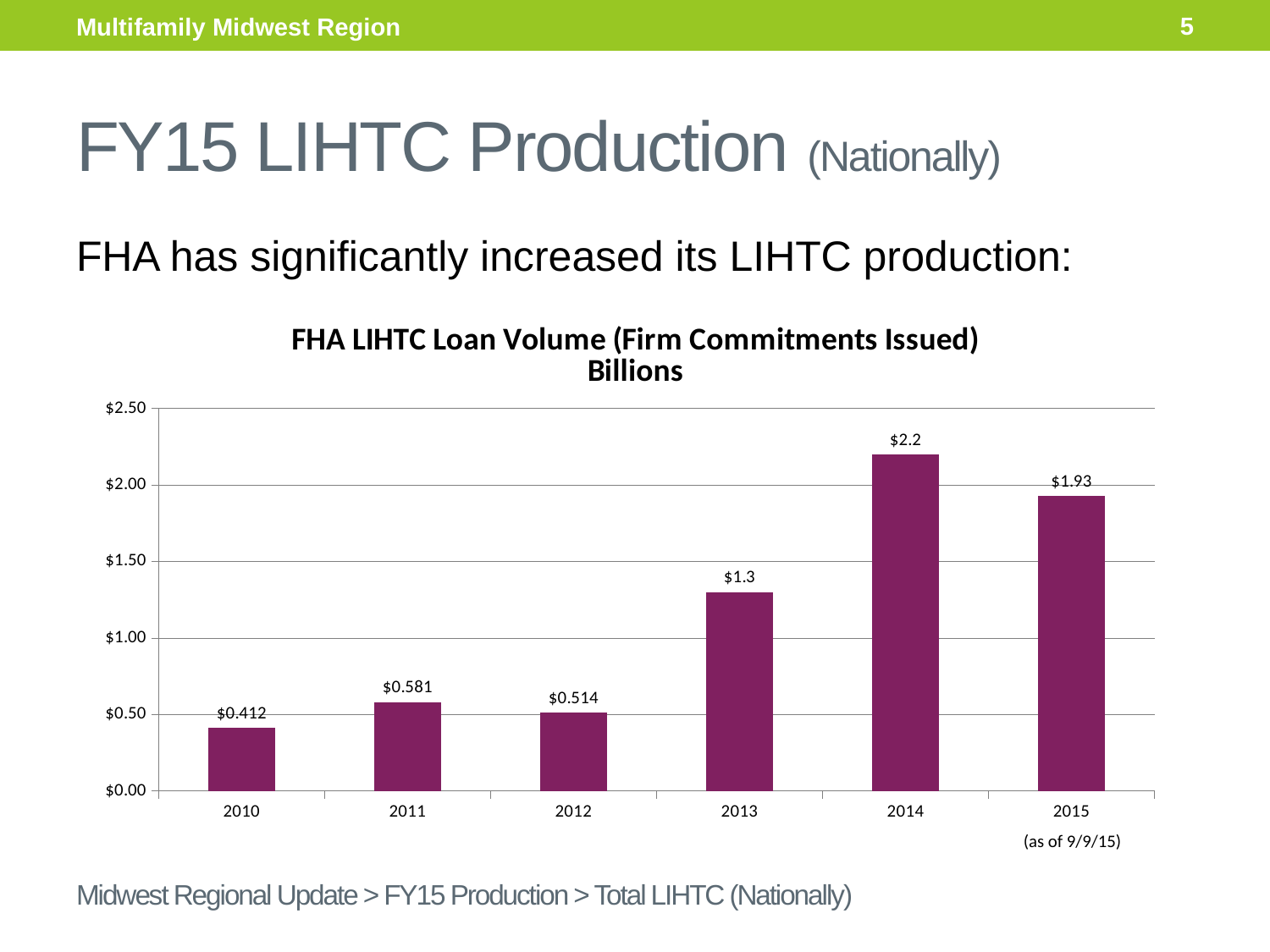
What is the difference between the 2014 and 2015 loan volumes? $0.27 What is the FHA LIHTC loan volume for 2010? $0.412 What is the FHA LIHTC loan volume for 2015? $1.93 Do the loan volumes rise or fall from 2012 to 2014? Rise What is the title of the chart? FHA LIHTC Loan Volume (Firm Commitments Issued) Billions What is the FHA LIHTC loan volume for 2013? $1.3 Which year has the highest FHA LIHTC loan volume? 2014 What kind of chart is shown on the slide? Bar chart How many years are shown on the chart? 6 Which year has the lowest FHA LIHTC loan volume? 2010 Is the value for 2013 greater or less than $1.00? greater Which year has a larger loan volume, 2011 or 2012? 2011